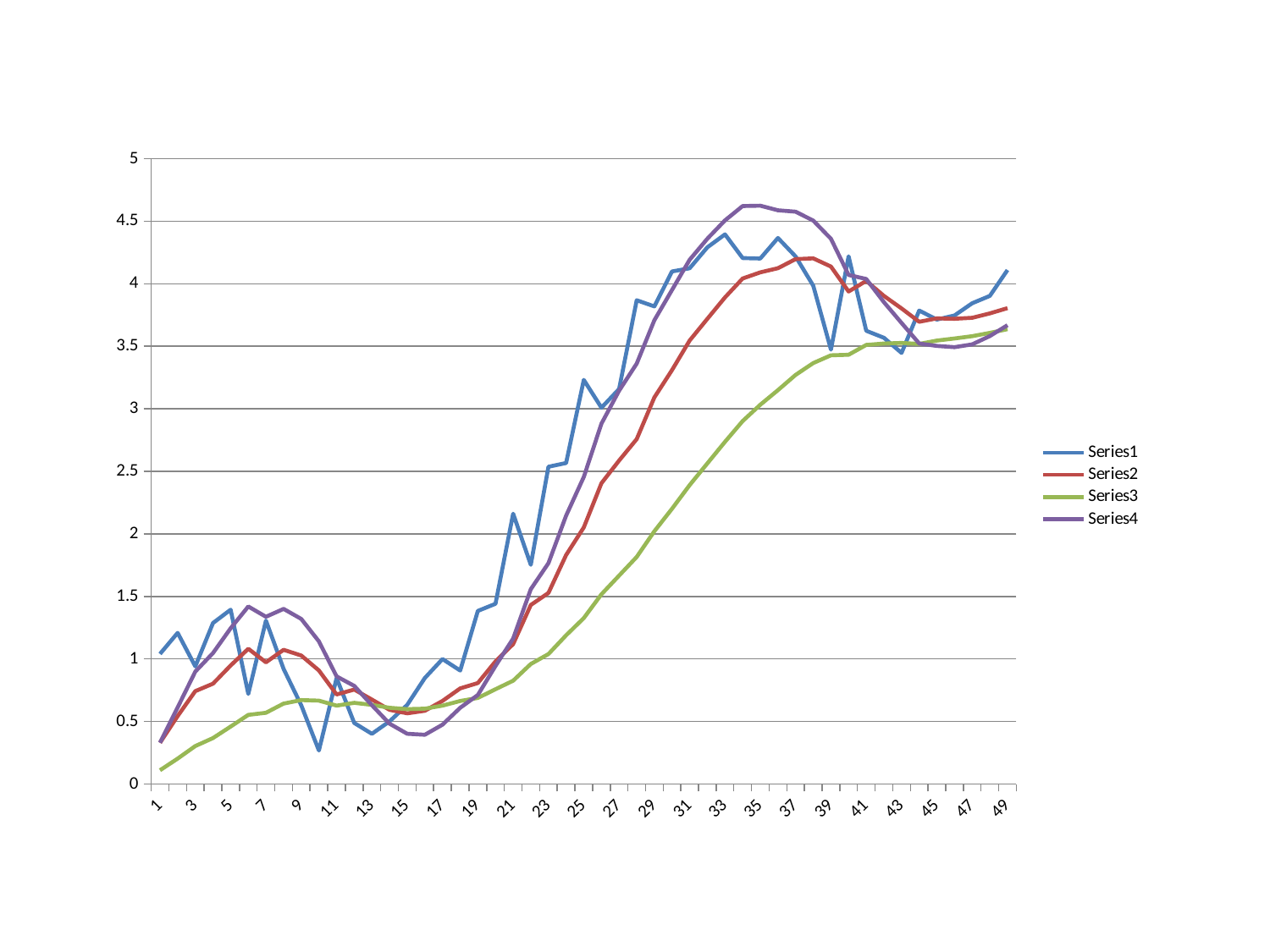
Which series reaches the highest peak value on the chart? Series4 What kind of chart is shown on the slide? line chart Does Series3 rise or fall between x = 15 and x = 39? rise What is the highest value shown on the y axis? 5 At x = 35, which is larger: Series4 or Series3? Series4 What are the names of the series listed in the legend? Series1, Series2, Series3, Series4 What is the last label shown on the x axis? 49 How many series does the legend list? 4 Is the value for Series2 at x = 49 greater or less than 4? less Is the value for Series4 at x = 35 greater or less than 4.5? greater Is the value for Series3 at x = 1 greater or less than 0.5? less